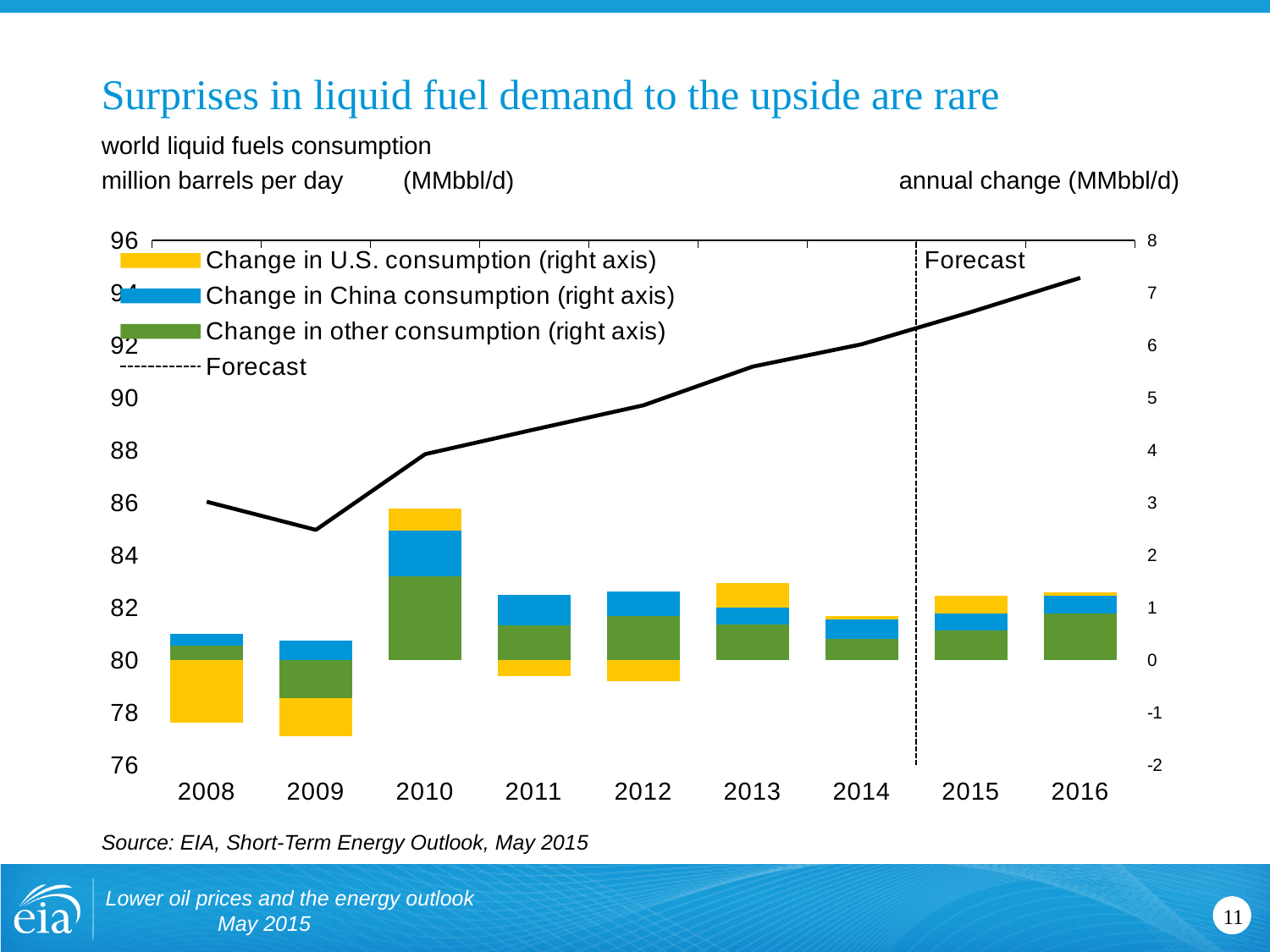
Is world liquid fuels consumption in 2014 greater or less than 90 million barrels per day? greater Does world liquid fuels consumption rise or fall from 2010 to 2016? rise How many years are shown on the x axis of the chart? 9 Which year has higher world liquid fuels consumption, 2008 or 2009? 2008 Which year has the largest total positive annual change in consumption? 2010 How many entries does the chart legend list? 4 What kind of chart is shown on the slide? A combined line and stacked bar chart Which years fall in the forecast period of the chart? 2015 and 2016 Is world liquid fuels consumption in 2010 greater or less than 86 million barrels per day? greater Is the change in U.S. consumption in 2008 greater or less than 0 MMbbl/d? less